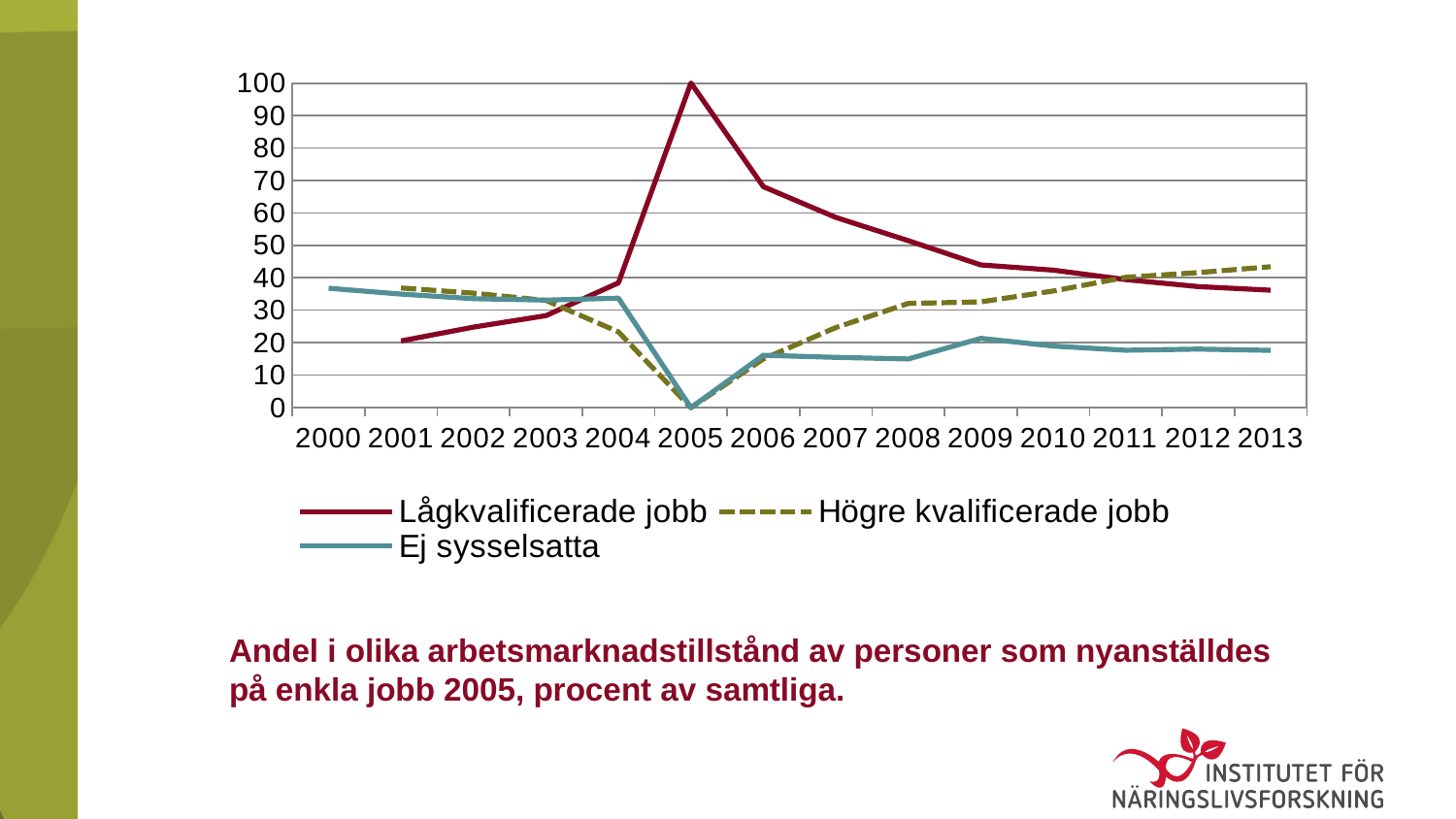
Is the value for Lågkvalificerade jobb in 2006 greater or less than 60? greater What kind of chart is shown on the slide? Line chart What is the value for Lågkvalificerade jobb in 2005? 100 How many series does the legend list? 3 Is the value for Ej sysselsatta in 2008 greater or less than 20? less What is the value for Ej sysselsatta in 2005? 0 Which series is drawn with a dashed line? Högre kvalificerade jobb In which year is Högre kvalificerade jobb at its lowest? 2005 Does the value for Lågkvalificerade jobb rise or fall from 2005 to 2013? Fall In 2013, which is larger: Högre kvalificerade jobb or Ej sysselsatta? Högre kvalificerade jobb In which year is Lågkvalificerade jobb at its highest? 2005 How many years are shown on the x axis? 14